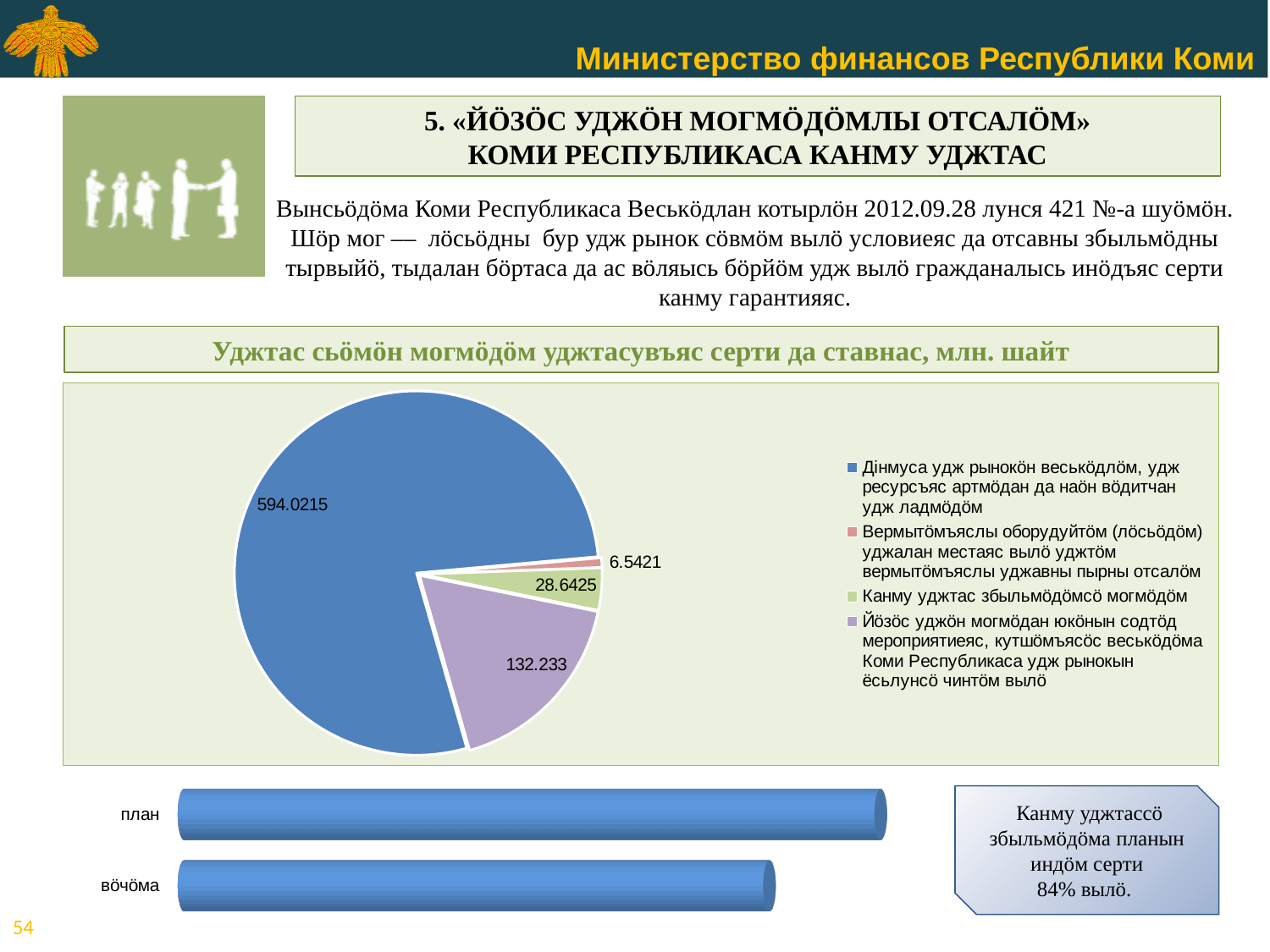
In the pie chart, what value is shown for the slice 'Вермытöмъяслы оборудуйтöм (лöсьöдöм) уджалан местаяс вылö уджтöм вермытöмъяслы уджавны пырны отсалöм'? 6.5421 In the pie chart, which legend entry corresponds to the smallest slice? Вермытöмъяслы оборудуйтöм (лöсьöдöм) уджалан местаяс вылö уджтöм вермытöмъяслы уджавны пырны отсалöм In the bar chart at the bottom of the slide, which bar is longer: 'план' or 'вöчöма'? план In the pie chart, what value is shown for the slice 'Йöзöс уджöн могмöдан юкöнын содтöд мероприятиеяс...'? 132.233 In the pie chart, what is the difference between the slice labelled 28.6425 and the slice labelled 6.5421? 22.1004 In the pie chart, which is larger: the slice labelled 132.233 or the slice labelled 28.6425? 132.233 How many entries does the legend of the pie chart list? 4 What unit is stated in the title of the pie chart? млн. шайт In the pie chart, what value is shown for the largest slice? 594.0215 In the pie chart, what is the difference between the largest slice (594.0215) and the slice labelled 132.233? 461.7885 In the pie chart, what value is shown for the slice 'Канму уджтас збыльмöдöмсö могмöдöм'? 28.6425 What kind of chart is shown at the bottom of the slide with the categories 'план' and 'вöчöма'? bar chart